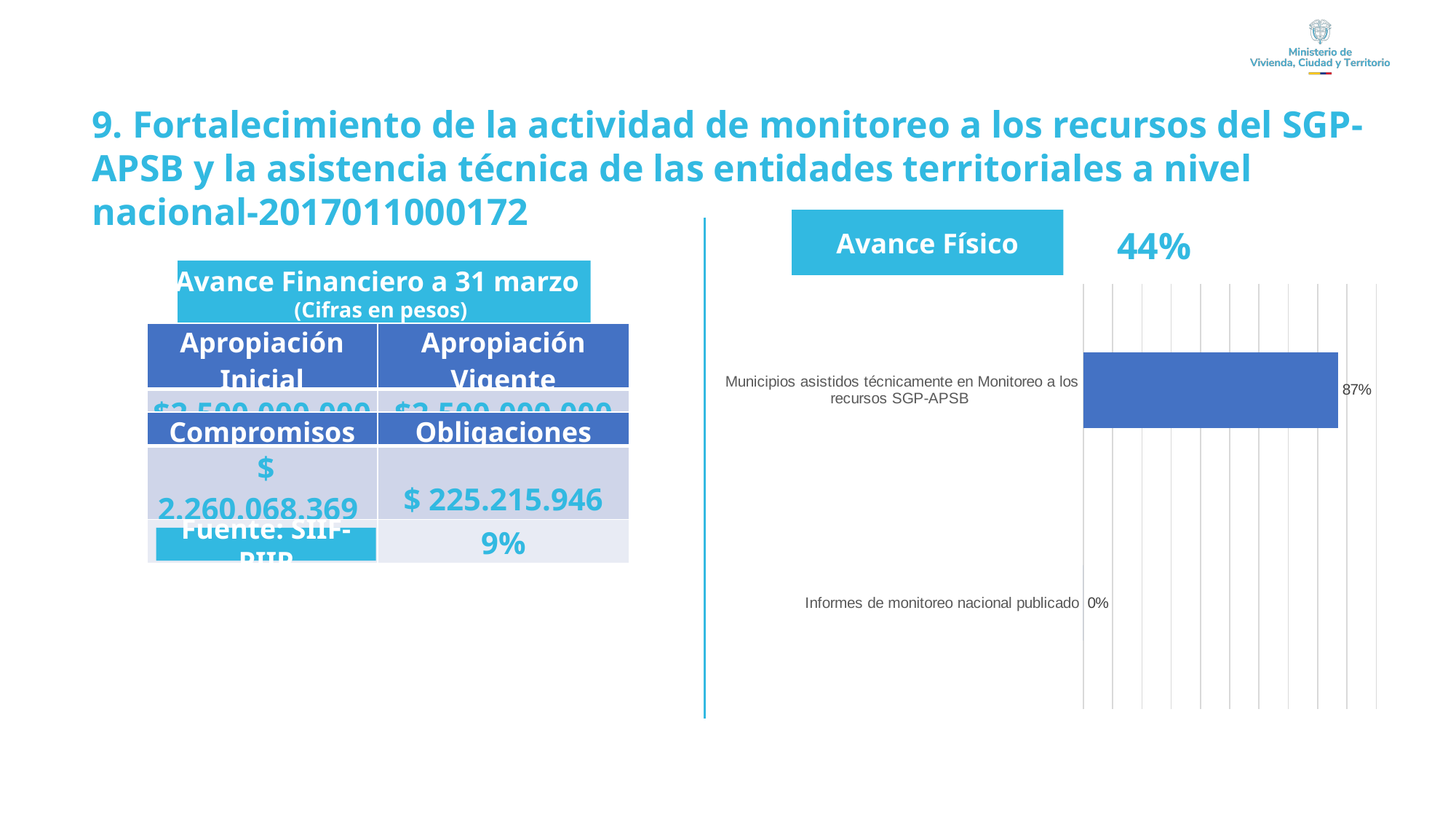
What is the title of the chart on the right side of the slide? Avance Físico What is the value for "Municipios asistidos técnicamente en Monitoreo a los recursos SGP-APSB" in the Avance Físico chart? 87% What overall percentage is shown next to the Avance Físico chart title? 44% How many categories are shown in the Avance Físico chart? 2 Which category has the lowest value in the Avance Físico chart? Informes de monitoreo nacional publicado What kind of chart is the Avance Físico chart? Bar chart What is the value for "Informes de monitoreo nacional publicado" in the Avance Físico chart? 0% In the Avance Físico chart, which is larger: the value for "Municipios asistidos técnicamente en Monitoreo a los recursos SGP-APSB" or the value for "Informes de monitoreo nacional publicado"? Municipios asistidos técnicamente en Monitoreo a los recursos SGP-APSB Which category has the highest value in the Avance Físico chart? Municipios asistidos técnicamente en Monitoreo a los recursos SGP-APSB What is the difference between the values for "Municipios asistidos técnicamente en Monitoreo a los recursos SGP-APSB" and "Informes de monitoreo nacional publicado" in the Avance Físico chart? 87%